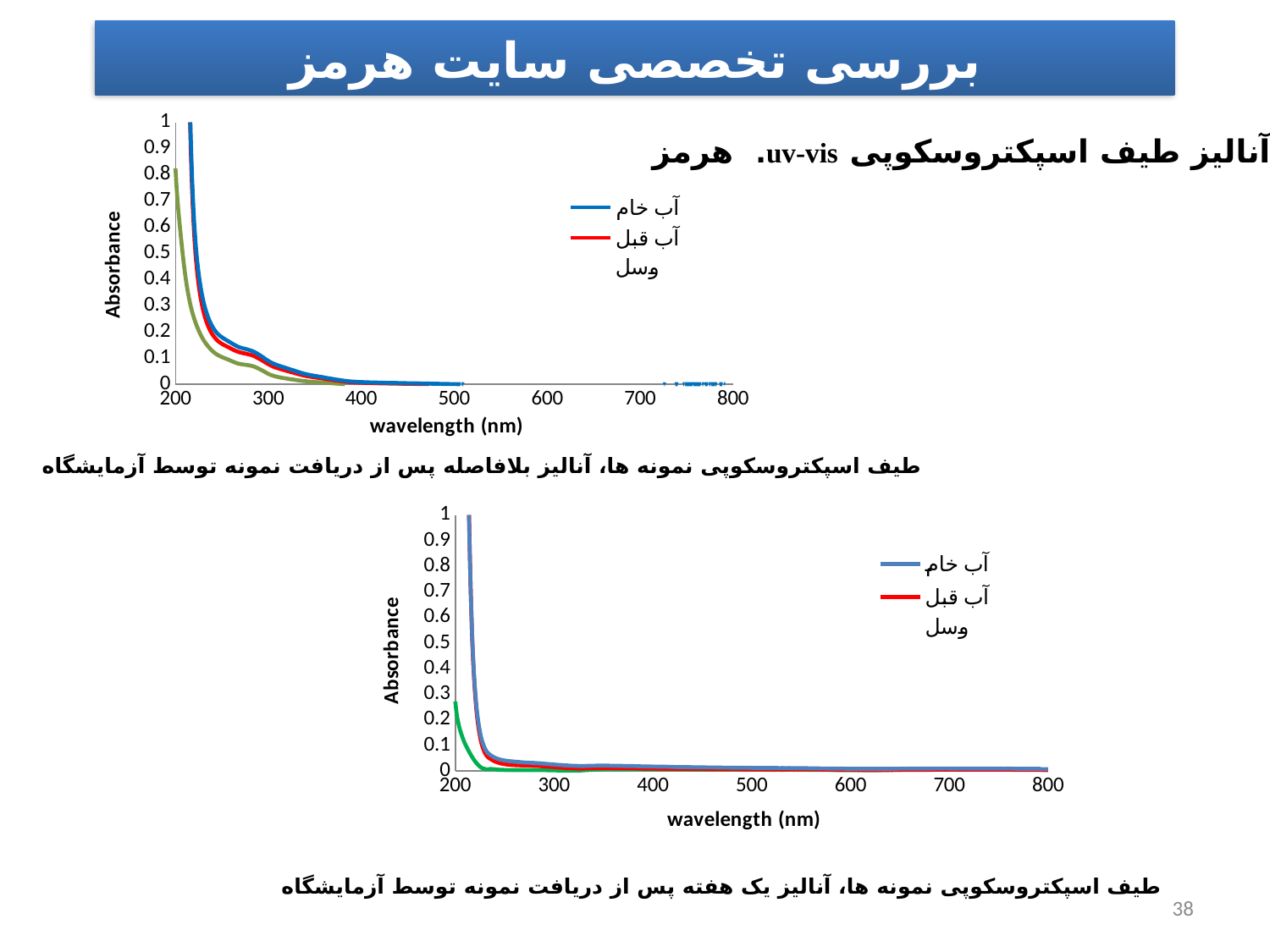
In the bottom chart, is the absorbance of the red line (آب قبل وسل) at 500 nm greater or less than 0.1? less In the top chart, is the absorbance of the blue line (آب خام) at 600 nm greater or less than 0.1? less In the top chart, how many series does the legend list? 2 What kind of chart is the top chart on the slide? line chart In the bottom chart, is the absorbance of the green line at 200 nm greater or less than 0.5? less What kind of chart is the bottom chart on the slide? line chart In the bottom chart, how many series does the legend list? 2 In the bottom chart, do the absorbance values rise or fall as wavelength increases from 200 to 800 nm? fall In the top chart, what is the label of the x axis? wavelength (nm) In the top chart, do the absorbance values rise or fall as wavelength increases from 200 to 800 nm? fall In the bottom chart, what is the label of the y axis? Absorbance